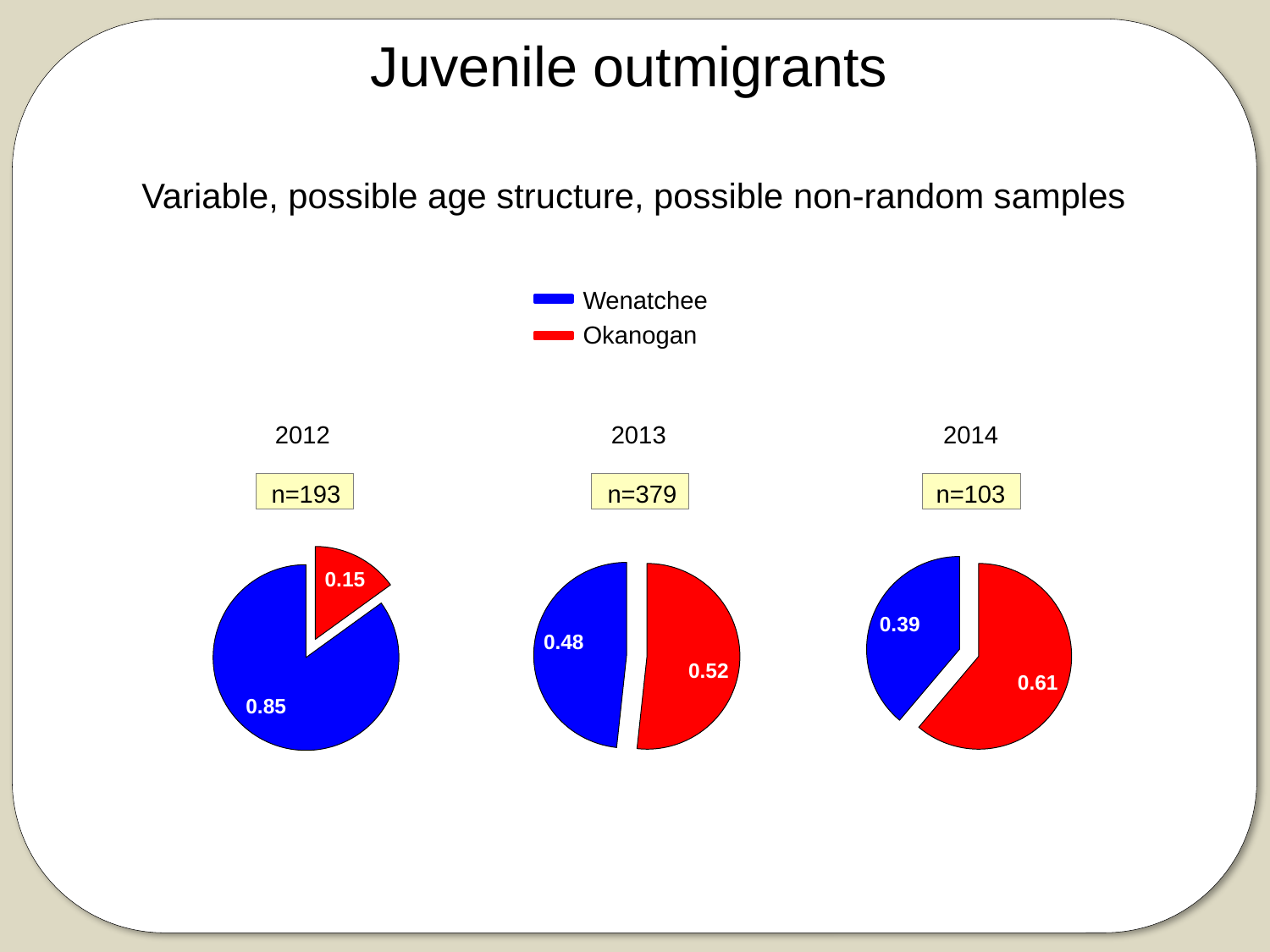
In the 2014 pie chart, what is the value for Wenatchee? 0.39 In the 2013 pie chart, what is the value for Wenatchee? 0.48 How many series does the legend list? 2 In the 2014 pie chart, what is the difference between the Okanogan and Wenatchee values? 0.22 In the 2014 pie chart, which slice is larger, Wenatchee or Okanogan? Okanogan What type of chart is used for the 2012, 2013 and 2014 data on the slide? pie chart In the 2012 pie chart, what is the difference between the Wenatchee and Okanogan values? 0.70 In the 2012 pie chart, what is the value for Okanogan? 0.15 In the 2012 pie chart, which slice is larger, Wenatchee or Okanogan? Wenatchee In the 2012 pie chart, what is the value for Wenatchee? 0.85 In the 2014 pie chart, what is the value for Okanogan? 0.61 What is the sample size (n) shown for the 2013 pie chart? n=379